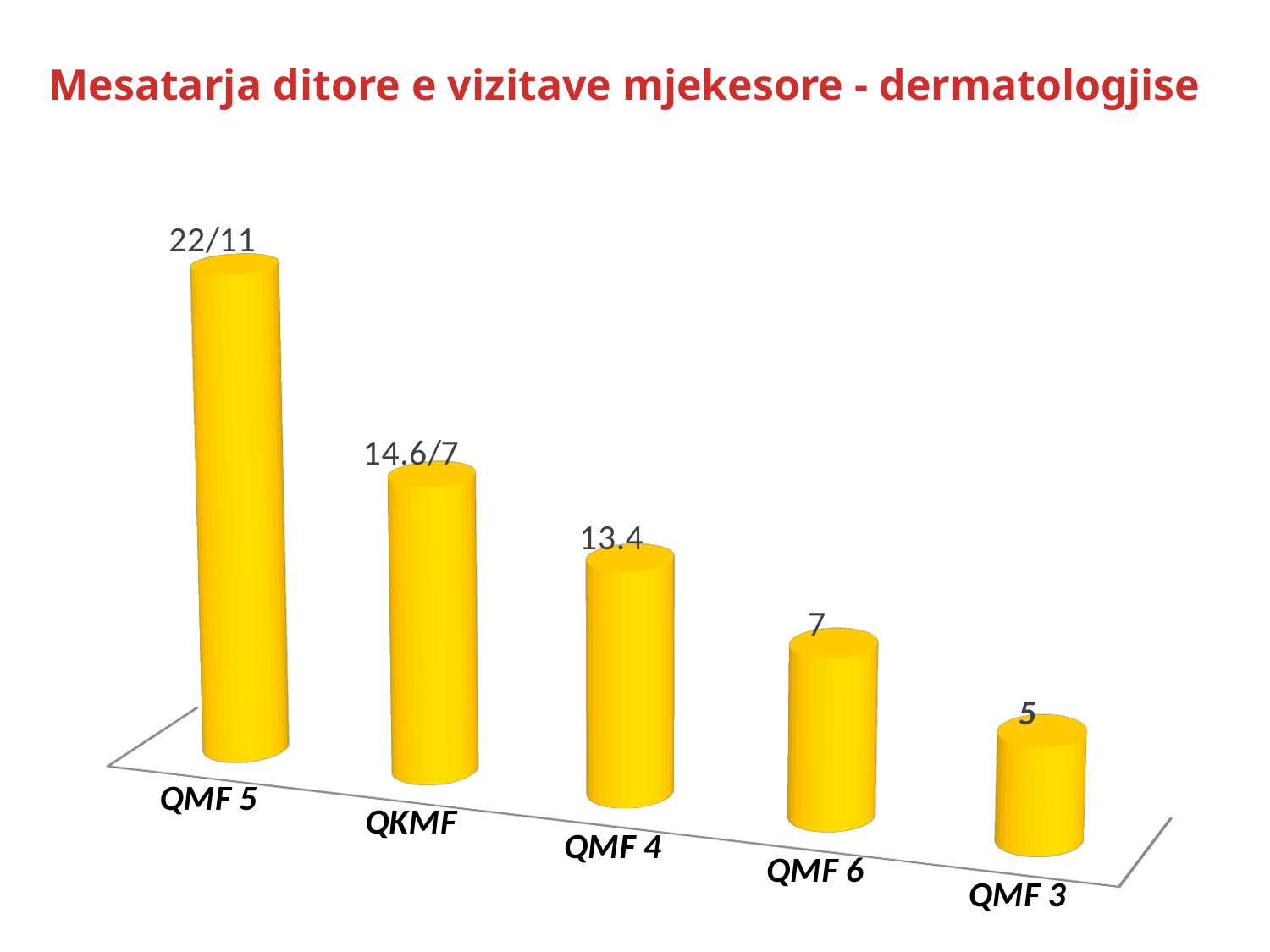
Which category has the highest bar? QMF 5 What is the value for QMF 3? 5 Which category has the lowest bar? QMF 3 What is the difference between the values for QMF 4 and QMF 6? 6.4 What is the value for QMF 4? 13.4 What is the value for QMF 6? 7 What is the difference between the values for QMF 6 and QMF 3? 2 How many categories are shown on the chart? 5 What is the data label shown for QKMF? 14.6/7 What is the data label shown for QMF 5? 22/11 Do the values rise or fall from left to right across the categories? fall Which is larger, the value for QMF 4 or the value for QMF 6? QMF 4